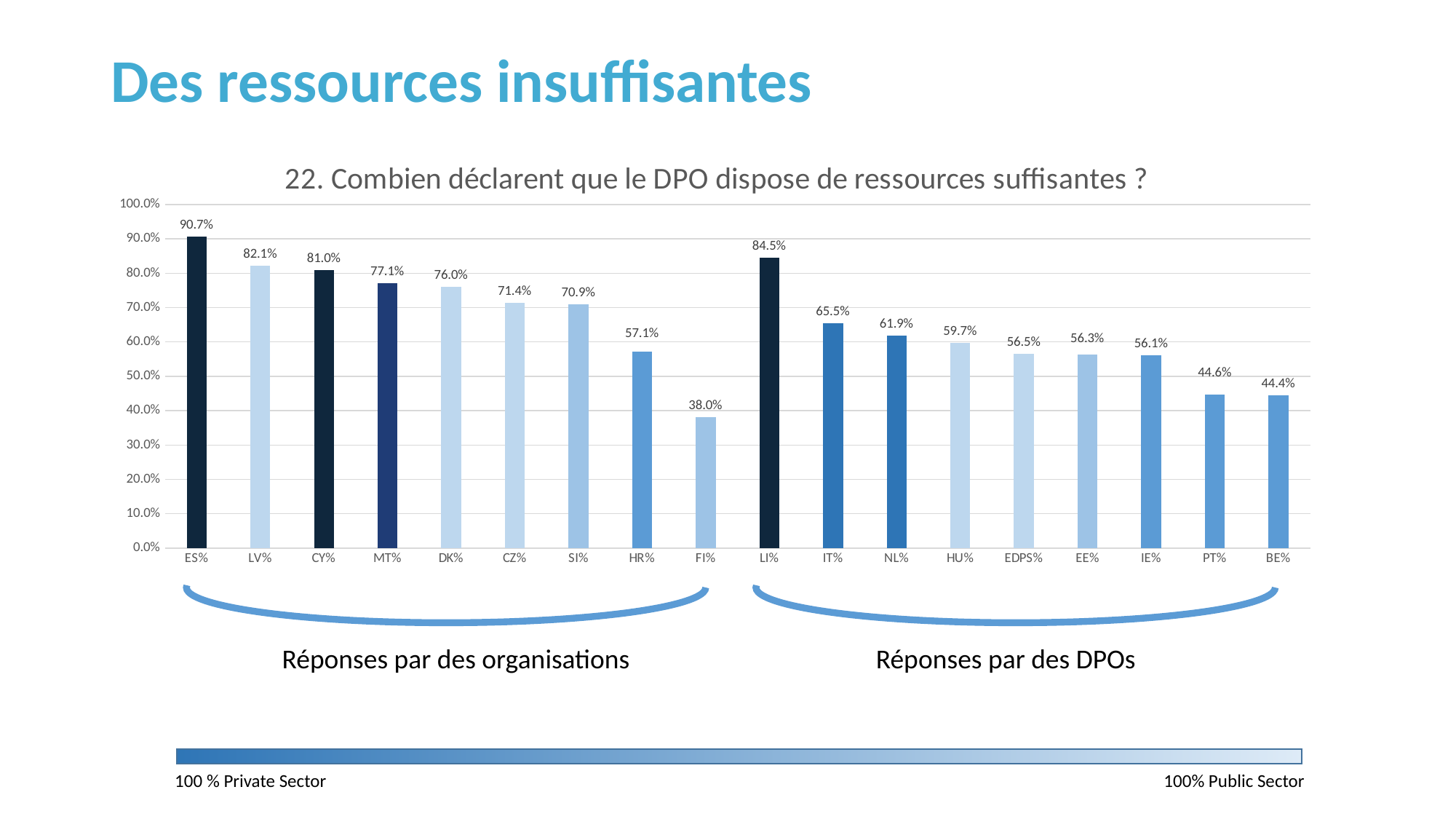
What kind of chart is this? bar chart What is the difference between the values for ES% and LI%? 6.2% Which is larger, the value for HR% or the value for IT%? IT% Which category has the highest value? ES% What is the title of the chart? 22. Combien déclarent que le DPO dispose de ressources suffisantes ? Which category has the lowest value? FI% What is the value for ES%? 90.7% Do the values rise or fall from ES% to FI%? fall What is the value for EDPS%? 56.5% What is the value for LI%? 84.5% How many categories are shown on the x axis? 18 Is the value for PT% greater or less than 50.0%? less